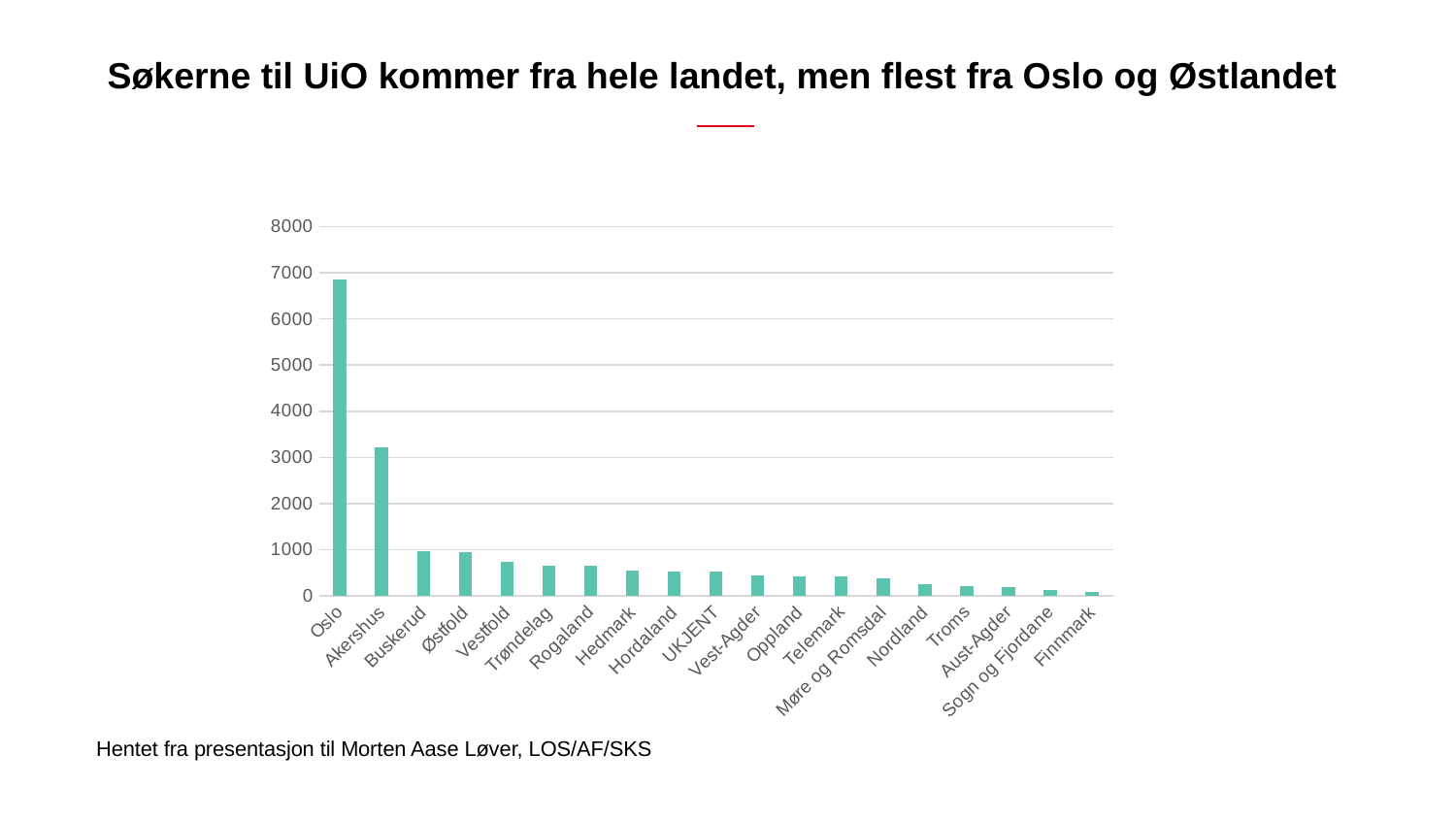
Is the value for Vestfold greater or less than 1000? less How many categories are shown on the x axis? 19 Is the value for Oslo greater or less than 6000? greater Is the value for Akershus greater or less than 4000? less What kind of chart is shown on the slide? bar chart Which is larger, the value for Oslo or the value for Akershus? Oslo Which category has the highest bar? Oslo Do the values rise or fall moving from left to right along the x axis? fall What is the title of the slide containing the chart? Søkerne til UiO kommer fra hele landet, men flest fra Oslo og Østlandet Which category has the lowest bar? Finnmark Which is larger, the value for Akershus or the value for Buskerud? Akershus